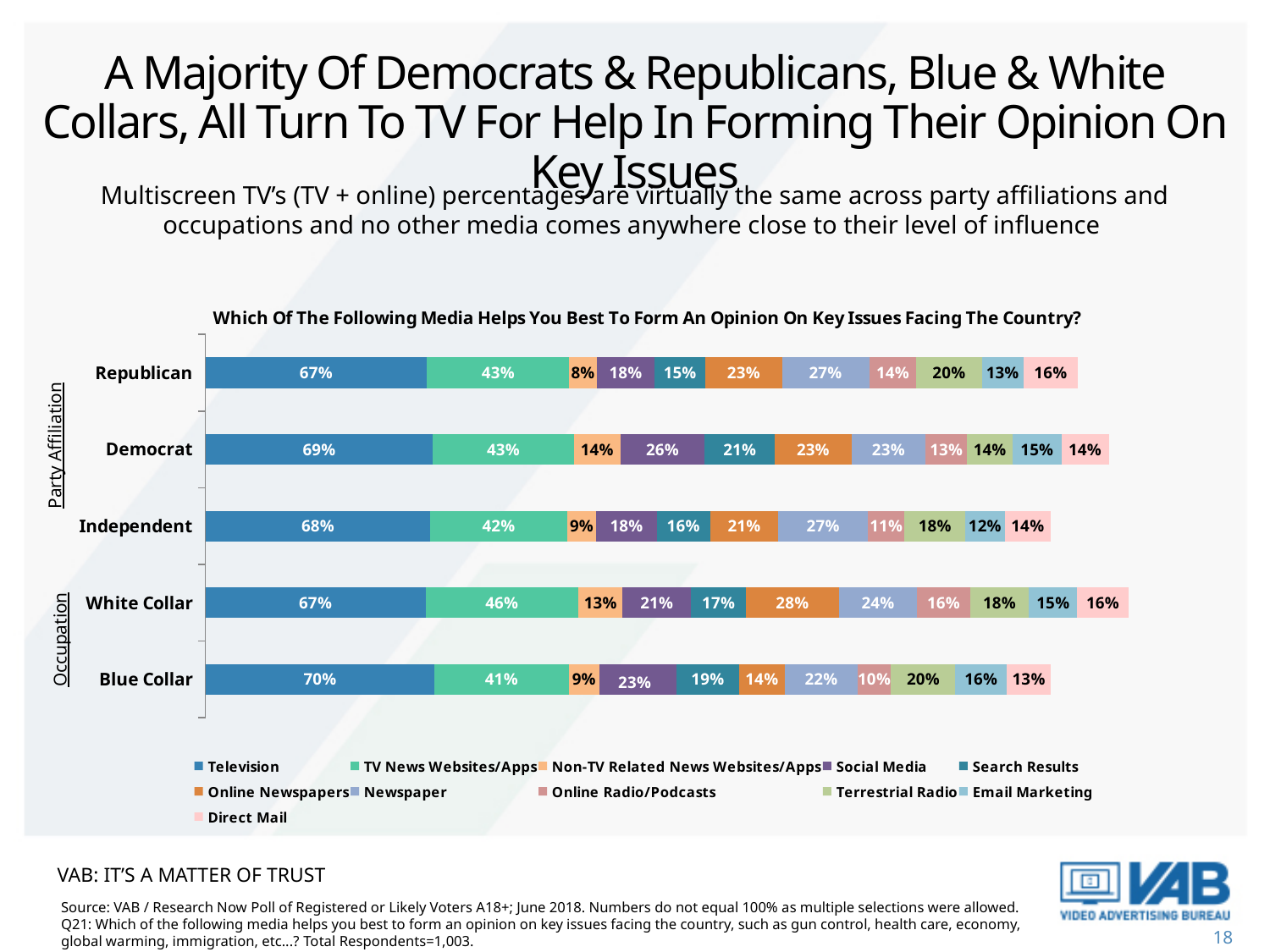
What is the difference between the Television values for Democrat and Republican? 2 percentage points What is the difference between the Social Media values for Democrat and Independent? 8 percentage points Which has a higher Newspaper value, Republican or Democrat? Republican What is the Newspaper value for Independent? 27% What kind of chart is shown on the slide? Stacked bar chart What is the Online Newspapers value for White Collar? 28% Which category has the highest Television value? Blue Collar How many categories are shown on the chart? 5 What is the Social Media value for Democrat? 26% What percentage of Blue Collar respondents chose Television? 70% How many series does the legend list? 11 Which category has the lowest TV News Websites/Apps value? Blue Collar